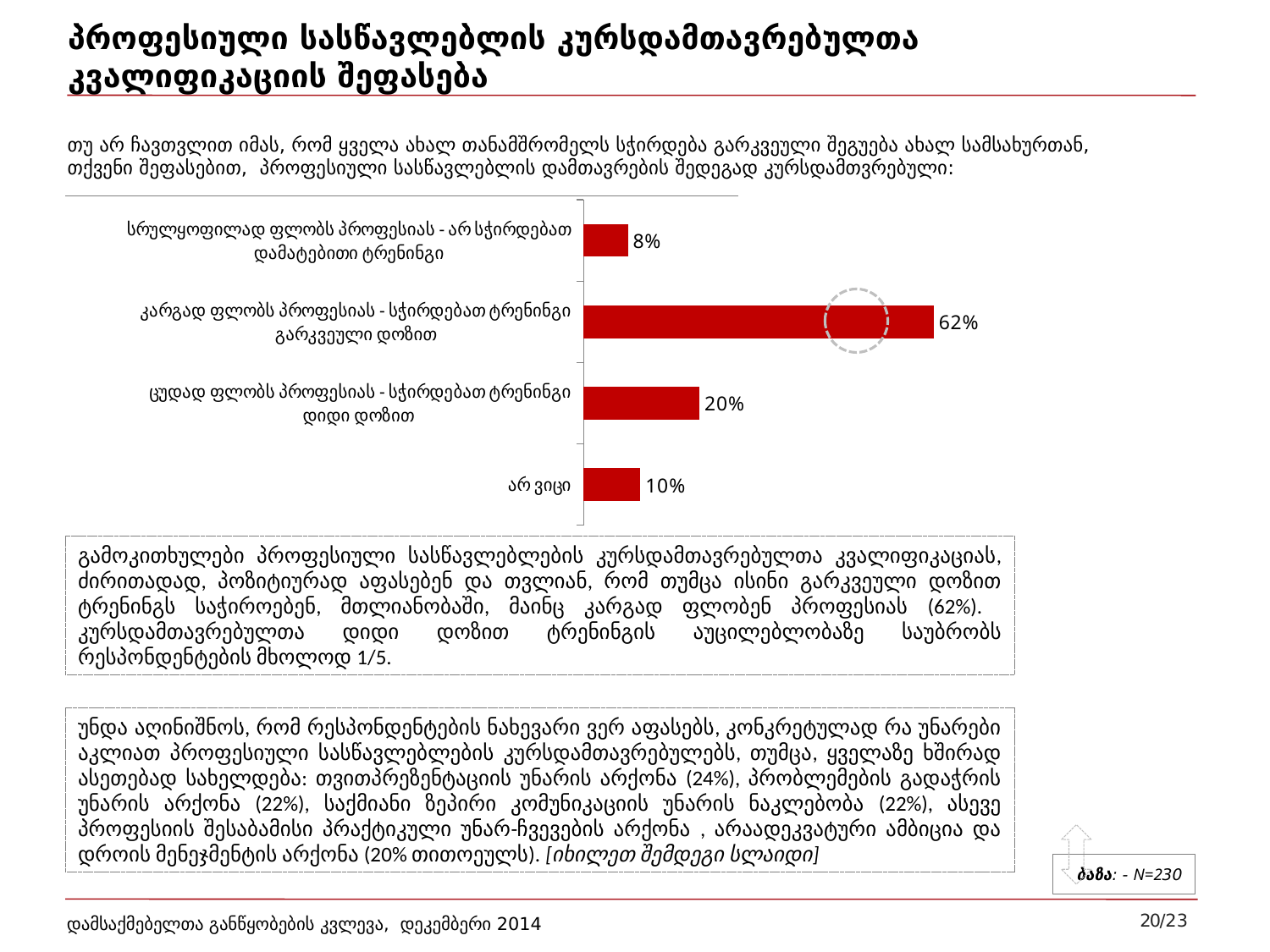
What is the difference between the values for "არ ვიცი" and "სრულყოფილად ფლობს პროფესიას - არ სჭირდებათ დამატებითი ტრენინგი"? 2% How many categories are shown in the chart? 4 What colour are the bars in the chart? Red Which is larger: the value for "ცუდად ფლობს პროფესიას - სჭირდებათ ტრენინგი დიდი დოზით" or the value for "არ ვიცი"? ცუდად ფლობს პროფესიას - სჭირდებათ ტრენინგი დიდი დოზით What is the value for the category "კარგად ფლობს პროფესიას - სჭირდებათ ტრენინგი გარკვეული დოზით"? 62% What is the difference between the values for "კარგად ფლობს პროფესიას - სჭირდებათ ტრენინგი გარკვეული დოზით" and "ცუდად ფლობს პროფესიას - სჭირდებათ ტრენინგი დიდი დოზით"? 42% Which category has the highest value? კარგად ფლობს პროფესიას - სჭირდებათ ტრენინგი გარკვეული დოზით What is the value for the category "არ ვიცი"? 10% What kind of chart is shown on the slide? Bar chart What is the value for the category "სრულყოფილად ფლობს პროფესიას - არ სჭირდებათ დამატებითი ტრენინგი"? 8% Which category has the lowest value? სრულყოფილად ფლობს პროფესიას - არ სჭირდებათ დამატებითი ტრენინგი What is the value for the category "ცუდად ფლობს პროფესიას - სჭირდებათ ტრენინგი დიდი დოზით"? 20%